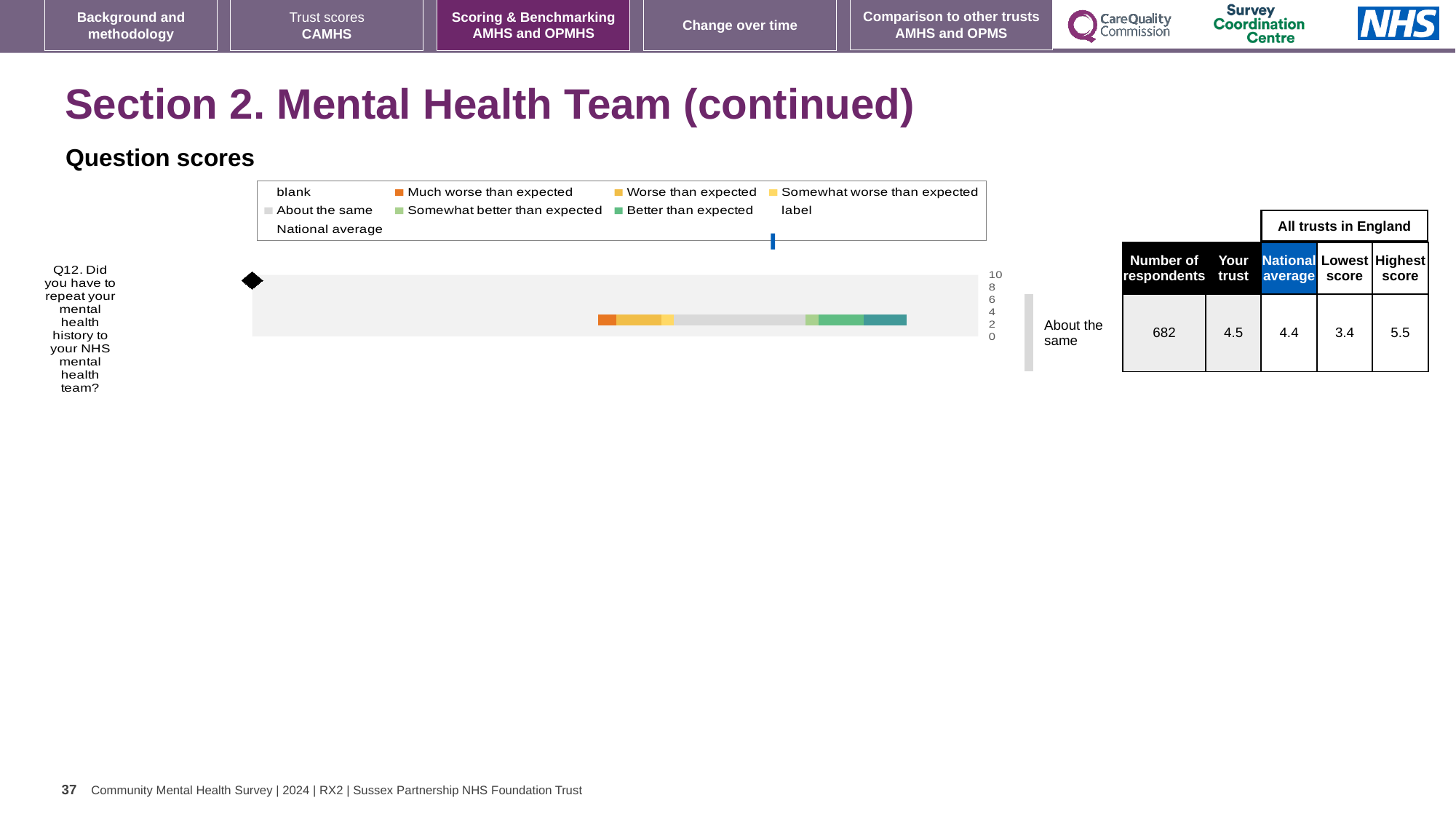
Which legend entry is shown in orange? Much worse than expected What is the lowest score among all trusts in England for Q12? 3.4 What is the heading above the 'National average', 'Lowest score' and 'Highest score' columns in the table? All trusts in England What is the difference between the highest score and the lowest score for Q12? 2.1 How many questions are plotted on the chart? 1 What is the highest score among all trusts in England for Q12? 5.5 What is the number of respondents for Q12 shown in the table next to the chart? 682 What is the national average score for Q12? 4.4 What is the 'Your trust' score for Q12 (Did you have to repeat your mental health history to your NHS mental health team?)? 4.5 What kind of chart is used to show the Q12 benchmarking result? Horizontal stacked bar chart How is the trust's result for Q12 categorised relative to expectations, according to the label beside the chart? About the same Which is larger for Q12: the 'Your trust' score or the national average? Your trust